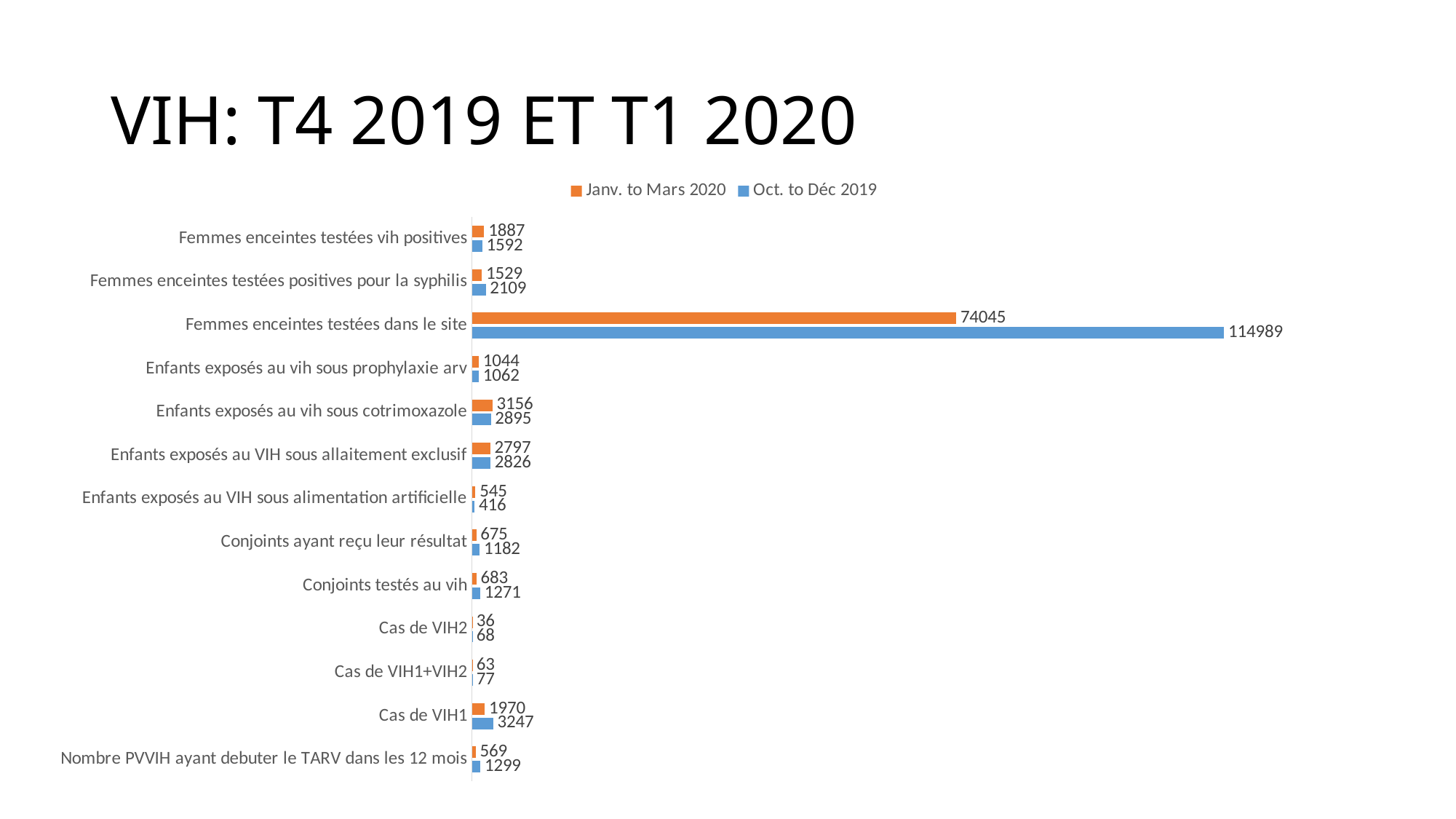
How many categories are shown on the chart? 13 What is the value for 'Femmes enceintes testées dans le site' in the Oct. to Déc 2019 series? 114989 Which category has the lowest value in the Janv. to Mars 2020 series? Cas de VIH2 Which is larger for 'Femmes enceintes testées positives pour la syphilis': the Janv. to Mars 2020 value or the Oct. to Déc 2019 value? Oct. to Déc 2019 Which category has the highest value in the Janv. to Mars 2020 series? Femmes enceintes testées dans le site How many series does the legend list? 2 Which colour represents the Janv. to Mars 2020 series? Orange What kind of chart is shown on the slide? Bar chart What is the difference between the Oct. to Déc 2019 and Janv. to Mars 2020 values for 'Femmes enceintes testées dans le site'? 40944 What is the value for 'Cas de VIH1' in the Janv. to Mars 2020 series? 1970 What is the value for 'Conjoints testés au vih' in the Oct. to Déc 2019 series? 1271 What is the difference between the Oct. to Déc 2019 and Janv. to Mars 2020 values for 'Cas de VIH1'? 1277